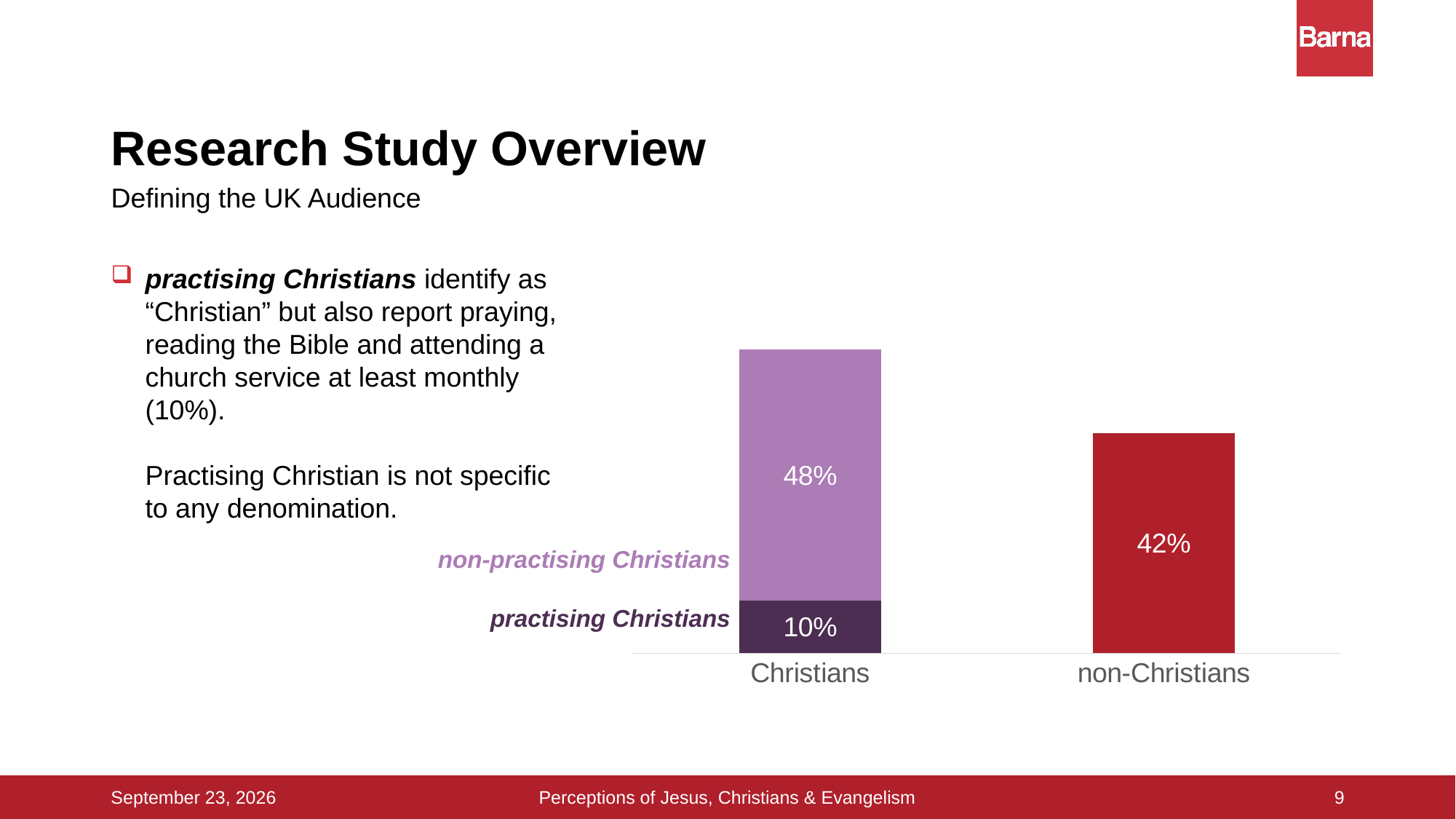
What is the difference between the non-practising Christians value and the non-Christians value? 6% Which is larger, the non-practising Christians segment or the non-Christians bar? non-practising Christians What kind of chart is shown on the slide? bar chart What colour is the non-Christians bar? red Which labelled segment has the largest value? non-practising Christians What is the difference between the non-practising Christians value and the practising Christians value? 38% What percentage of the Christians bar is labelled as non-practising Christians? 48% What is the total of the stacked Christians bar? 58% What percentage of the Christians bar is labelled as practising Christians? 10% How many categories are shown on the x axis? 2 Which labelled segment has the smallest value? practising Christians What value is shown for non-Christians? 42%